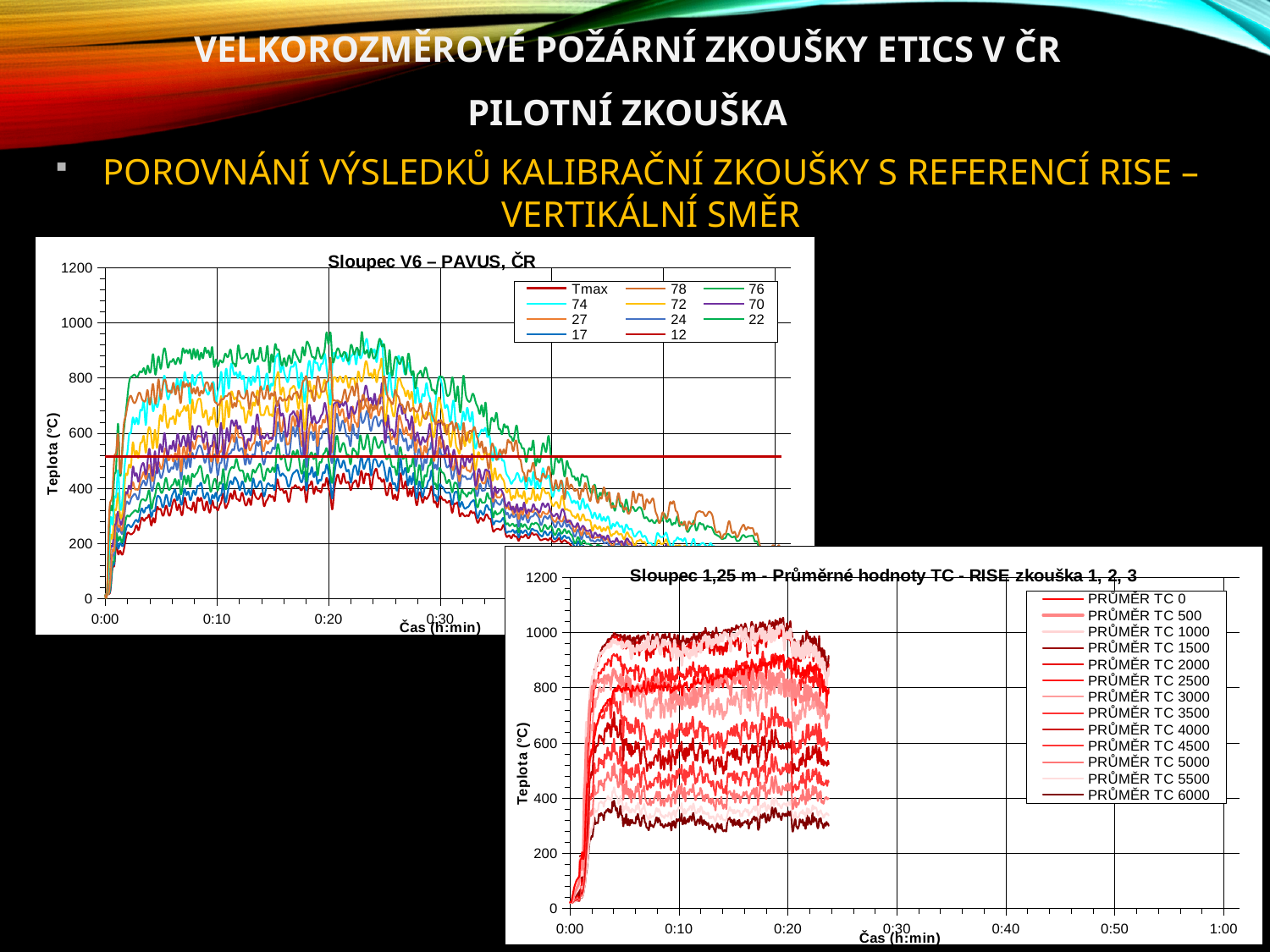
In the bottom-right chart "Sloupec 1,25 m - Průměrné hodnoty TC - RISE zkouška 1, 2, 3", is the plateau value of PRŮMĚR TC 0 greater or less than 800 °C? greater In the bottom-right chart "Sloupec 1,25 m - Průměrné hodnoty TC - RISE zkouška 1, 2, 3", do the temperature curves rise or fall between 0:00 and 0:05 on the time axis? rise In the top-left chart "Sloupec V6 – PAVUS, ČR", is the peak value of series 76 greater or less than 800 °C? greater In the top-left chart "Sloupec V6 – PAVUS, ČR", is the horizontal Tmax line greater or less than 400 °C? greater What kind of chart is the top-left chart titled "Sloupec V6 – PAVUS, ČR"? line chart In the top-left chart "Sloupec V6 – PAVUS, ČR", do the temperature curves rise or fall between 0:30 and 0:50 on the time axis? fall What is the label of the vertical axis on the top-left chart "Sloupec V6 – PAVUS, ČR"? Teplota (°C) What kind of chart is the bottom-right chart titled "Sloupec 1,25 m - Průměrné hodnoty TC - RISE zkouška 1, 2, 3"? line chart How many series does the legend of the top-left chart "Sloupec V6 – PAVUS, ČR" list? 11 How many series does the legend of the bottom-right chart "Sloupec 1,25 m - Průměrné hodnoty TC - RISE zkouška 1, 2, 3" list? 13 What is the highest tick value shown on the vertical axis of the bottom-right chart "Sloupec 1,25 m - Průměrné hodnoty TC - RISE zkouška 1, 2, 3"? 1200